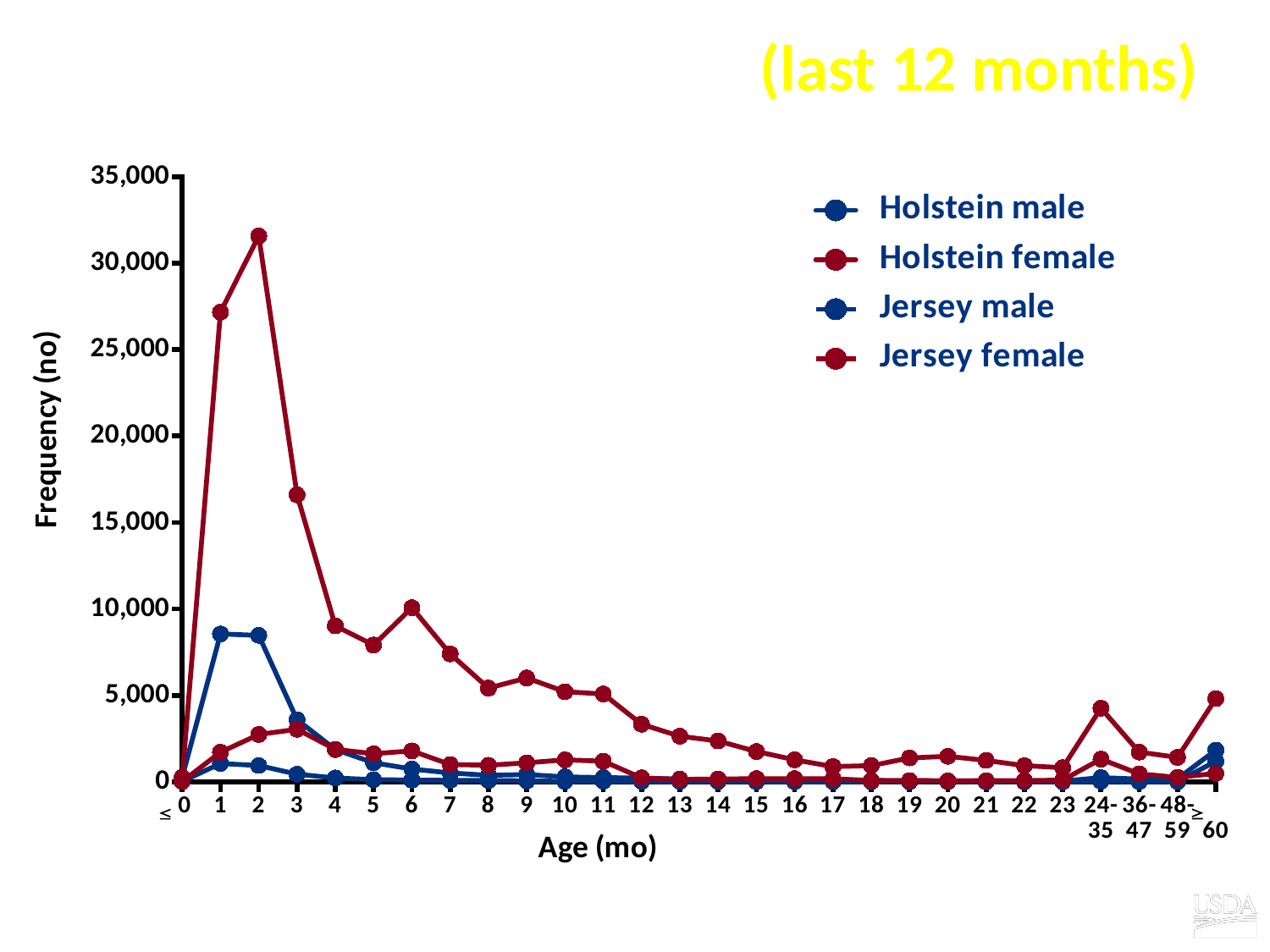
At which age (mo) does the highest red line reach its peak? 2 From age 2 to age 12, does the highest red line rise or fall? fall How many age categories are shown on the x axis? 28 What is the label of the x axis? Age (mo) What kind of chart is shown on the slide? line chart Is the value of the highest red line at age 1 greater or less than 25,000? greater How many series does the legend list? 4 Is the peak value of the highest red line at age 2 greater or less than 30,000? greater What is the label of the y axis? Frequency (no) Is the value of the highest red line at age 4 greater or less than 10,000? less